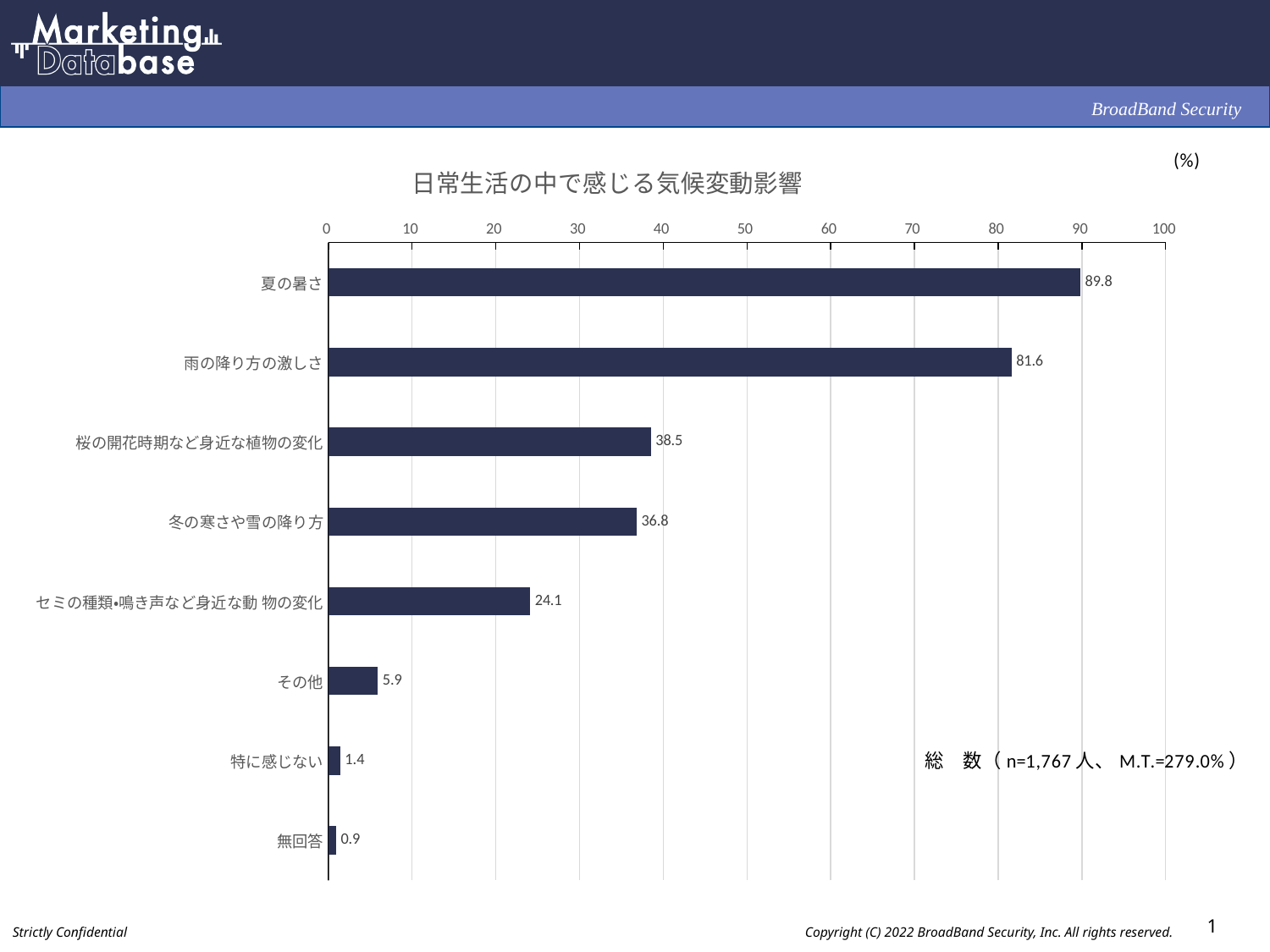
What is the value for 雨の降り方の激しさ? 81.6 What is the difference between the values for 夏の暑さ and 雨の降り方の激しさ? 8.2 What is the value for 特に感じない? 1.4 Is the value for その他 greater or less than 10? less What is the value for 夏の暑さ? 89.8 What is the title of the chart? 日常生活の中で感じる気候変動影響 What kind of chart is shown on the slide? bar chart Which category has the highest value? 夏の暑さ How many categories are shown in the chart? 8 Which is larger, the value for 桜の開花時期など身近な植物の変化 or the value for セミの種類•鳴き声など身近な動物の変化? 桜の開花時期など身近な植物の変化 What is the value for 冬の寒さや雪の降り方? 36.8 Which category has the lowest value? 無回答